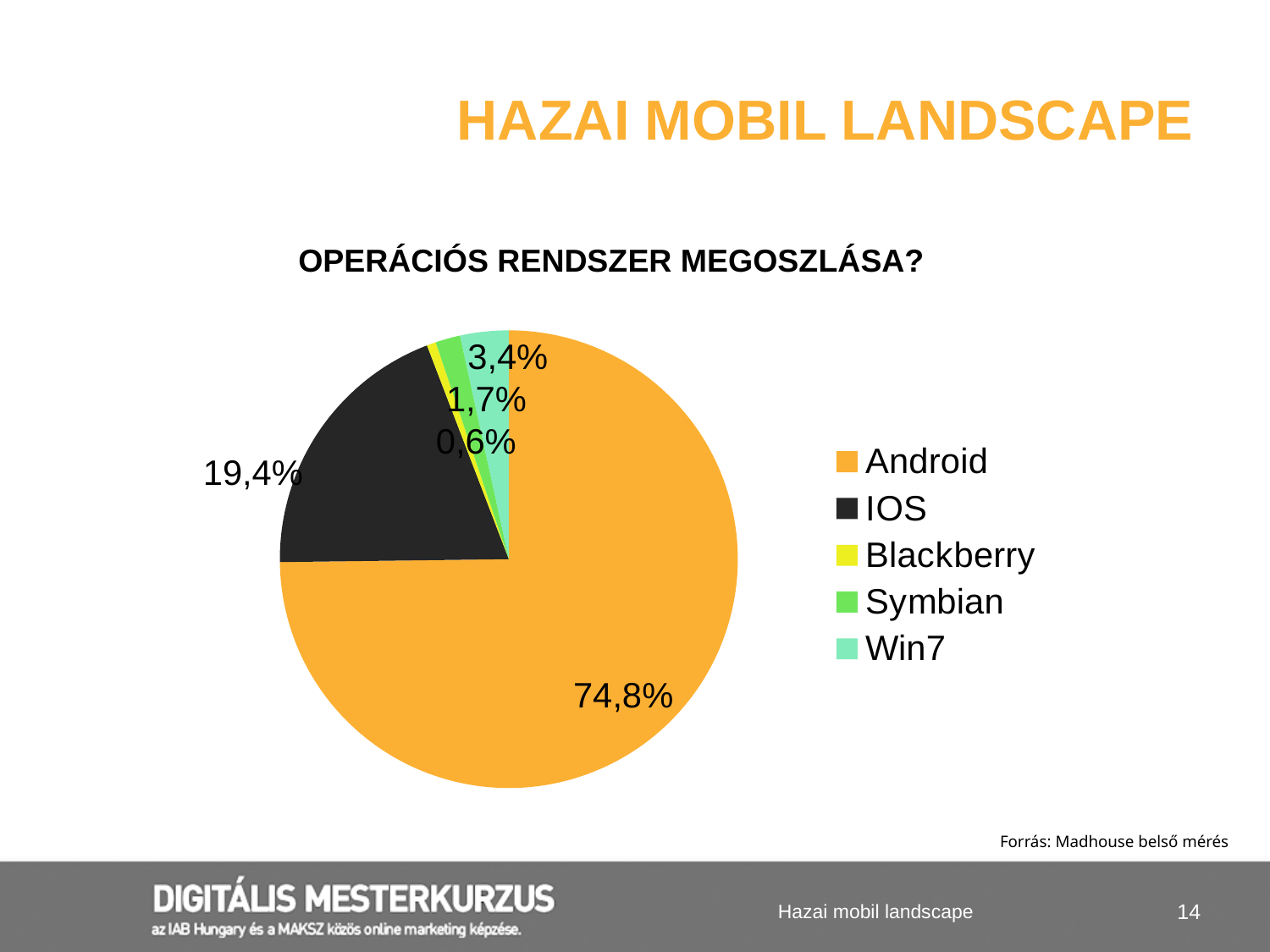
What kind of chart is shown on the slide? pie chart How many categories does the legend list? 5 Which operating system has the largest slice of the pie? Android What share of the pie does Blackberry have? 0,6% What share of the pie does Android have? 74,8% Which operating system has the smallest slice of the pie? Blackberry Which is larger, the share for Win7 or the share for Symbian? Win7 What share of the pie does IOS have? 19,4% What share of the pie does Win7 have? 3,4% What is the chart's title? OPERÁCIÓS RENDSZER MEGOSZLÁSA? What is the difference between the Android and IOS shares? 55,4% What share of the pie does Symbian have? 1,7%